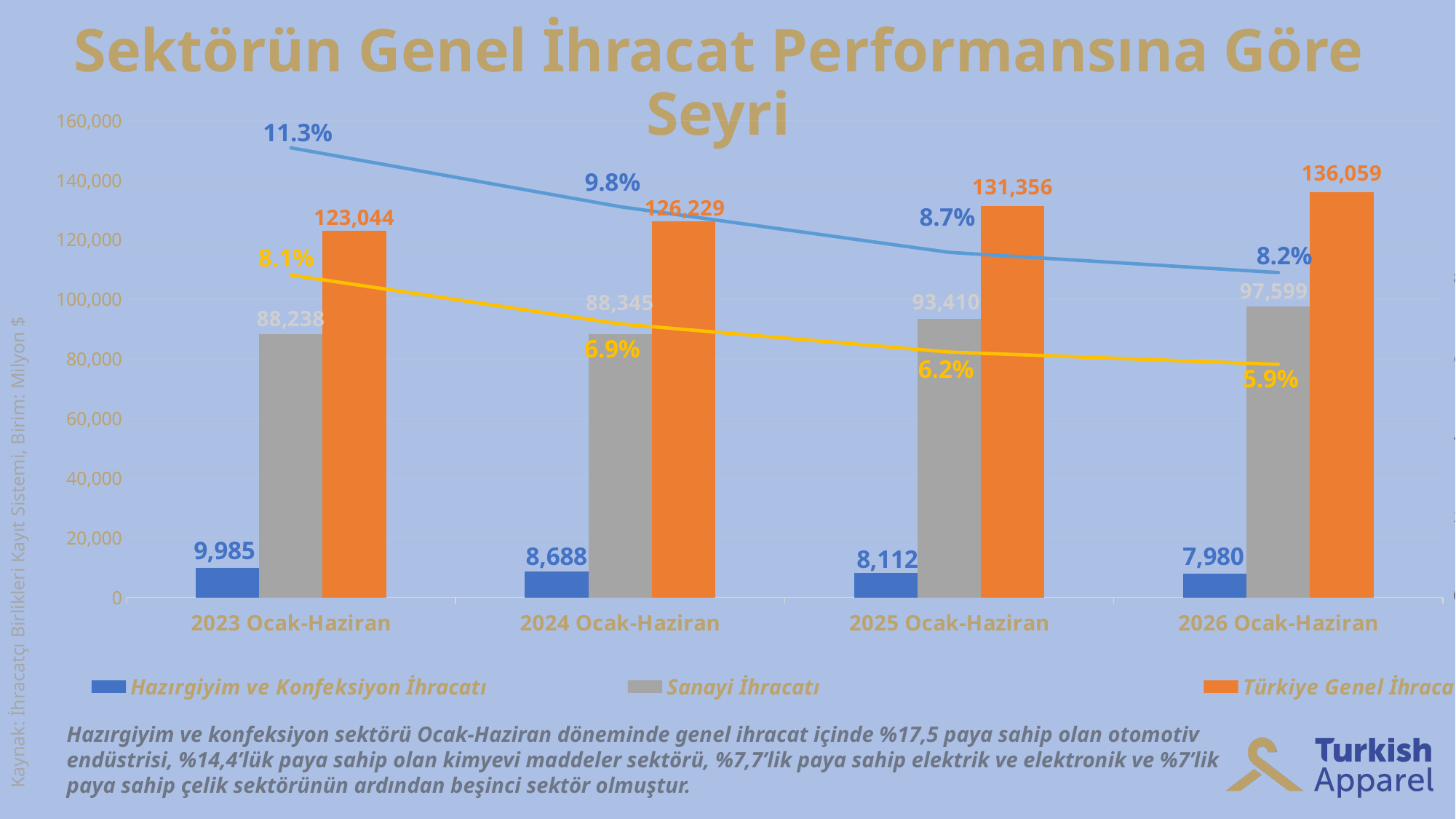
What is the difference between Sanayi İhracatı in 2026 Ocak-Haziran and 2023 Ocak-Haziran? 9,361 Do the Hazırgiyim ve Konfeksiyon İhracatı values rise or fall from 2023 to 2026 Ocak-Haziran? fall In which period is Sanayi İhracatı highest? 2026 Ocak-Haziran What is the value of Hazırgiyim ve Konfeksiyon İhracatı for 2023 Ocak-Haziran? 9,985 How many periods are shown on the x axis? 4 What is the value of Sanayi İhracatı for 2025 Ocak-Haziran? 93,410 What percentage does the blue line show for 2024 Ocak-Haziran? 9.8% What is the value of the orange bar (Türkiye Genel İhracatı) for 2026 Ocak-Haziran? 136,059 Which is larger in 2024 Ocak-Haziran: Sanayi İhracatı or Hazırgiyim ve Konfeksiyon İhracatı? Sanayi İhracatı In which period is Hazırgiyim ve Konfeksiyon İhracatı lowest? 2026 Ocak-Haziran What percentage does the yellow line show for 2025 Ocak-Haziran? 6.2% What unit is given for the values on the chart? Milyon $